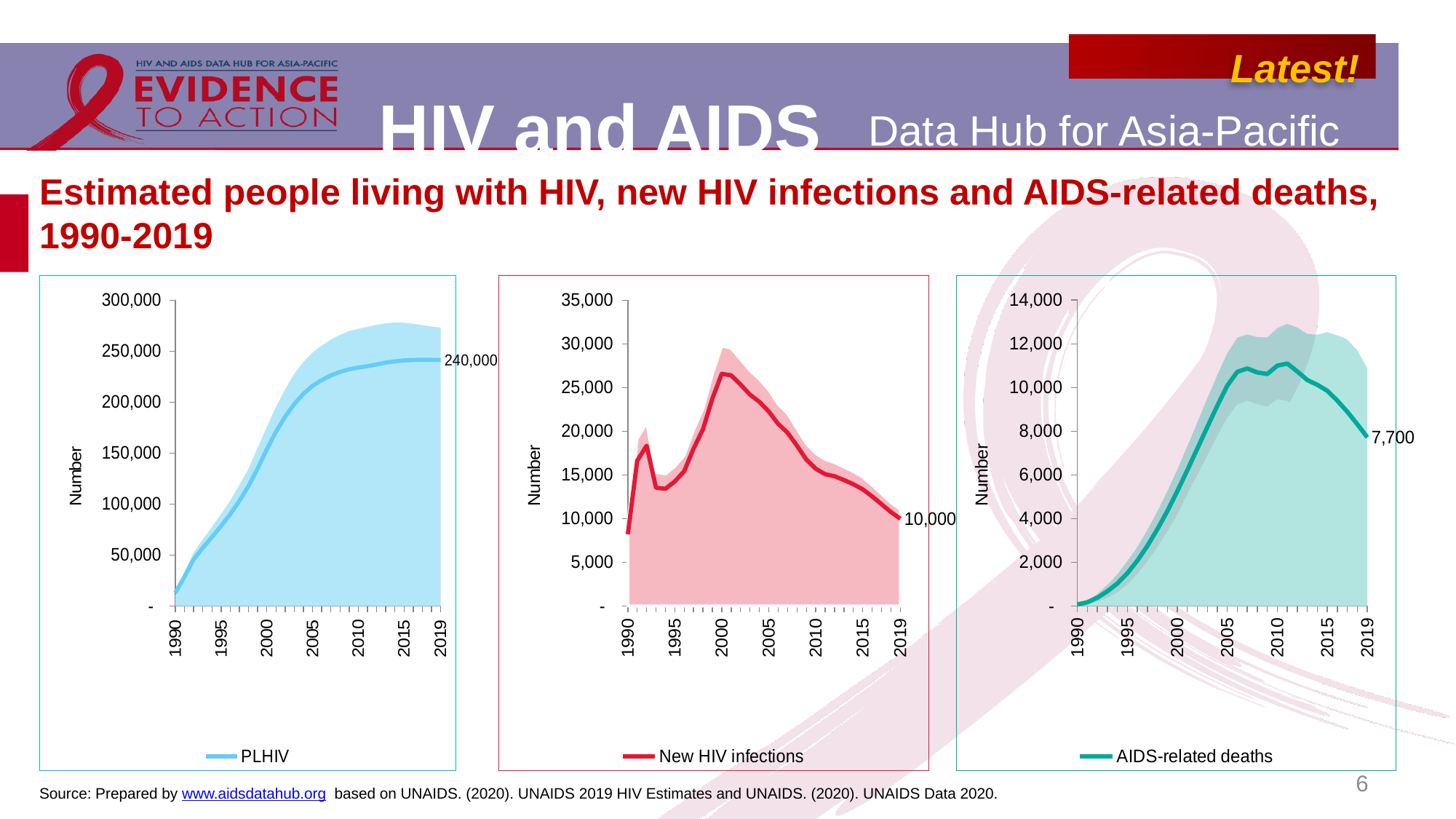
How many series does the legend of the right chart list? 1 In the middle chart (New HIV infections), does the line rise or fall from 2000 to 2019? fall What kind of chart is the left chart (PLHIV)? combination area and line chart (a line with a shaded area band) In the right chart (AIDS-related deaths), what is the value shown for 2019? 7,700 In the right chart (AIDS-related deaths), does the line rise or fall from 2010 to 2019? fall In the right chart (AIDS-related deaths), is the value for 2010 greater or less than 10,000? greater In the middle chart (New HIV infections), what is the value shown for 2019? 10,000 In the middle chart (New HIV infections), is the value for 2000 greater or less than 25,000? greater Which is larger: the 2019 value in the middle chart (New HIV infections) or the 2019 value in the right chart (AIDS-related deaths)? New HIV infections In the left chart (PLHIV), does the line generally rise or fall from 1990 to 2019? rise In the left chart (PLHIV), what is the value shown for 2019? 240,000 In the left chart (PLHIV), is the value for 2000 greater or less than 200,000? less